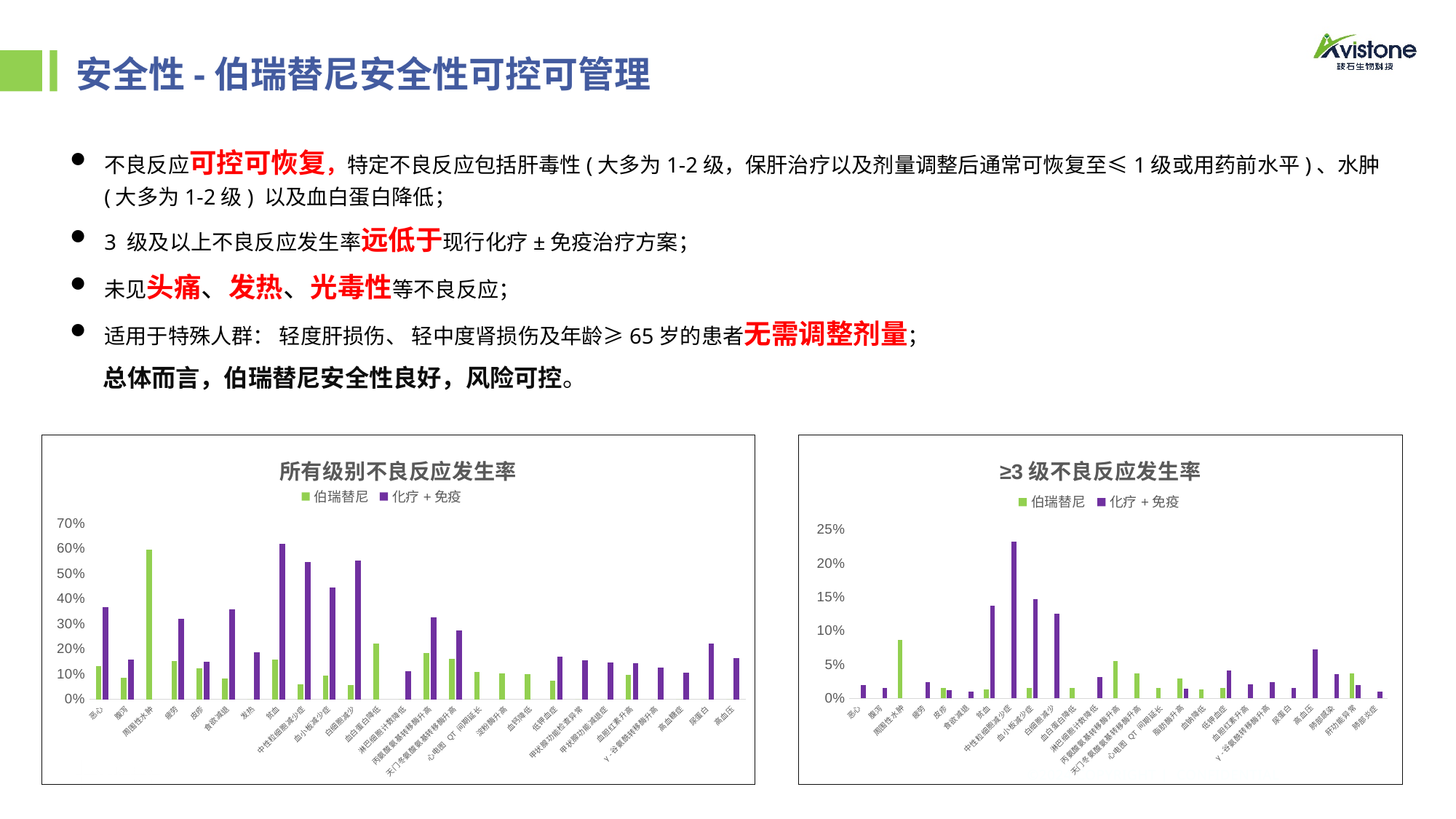
In the left chart (所有级别不良反应发生率), is the 伯瑞替尼 value for 恶心 greater or less than 20%? less In the right chart (≥3 级不良反应发生率), is the 伯瑞替尼 value for 周围性水肿 greater or less than 10%? less In the left chart (所有级别不良反应发生率), which series has the larger value for 贫血, 伯瑞替尼 or 化疗 + 免疫? 化疗 + 免疫 In the right chart (≥3 级不良反应发生率), is the 化疗 + 免疫 value for 中性粒细胞减少症 greater or less than 20%? greater In the left chart, which series is shown in green? 伯瑞替尼 In the left chart (所有级别不良反应发生率), which category has the highest value for the 化疗 + 免疫 series? 贫血 In the left chart (所有级别不良反应发生率), which category has the highest value for the 伯瑞替尼 series? 周围性水肿 How many series does the legend of the right chart (≥3 级不良反应发生率) list? 2 What kind of chart is the left chart titled 所有级别不良反应发生率? bar chart In the right chart (≥3 级不良反应发生率), which series has the larger value for 贫血, 伯瑞替尼 or 化疗 + 免疫? 化疗 + 免疫 In the right chart (≥3 级不良反应发生率), which category has the highest bar overall? 中性粒细胞减少症